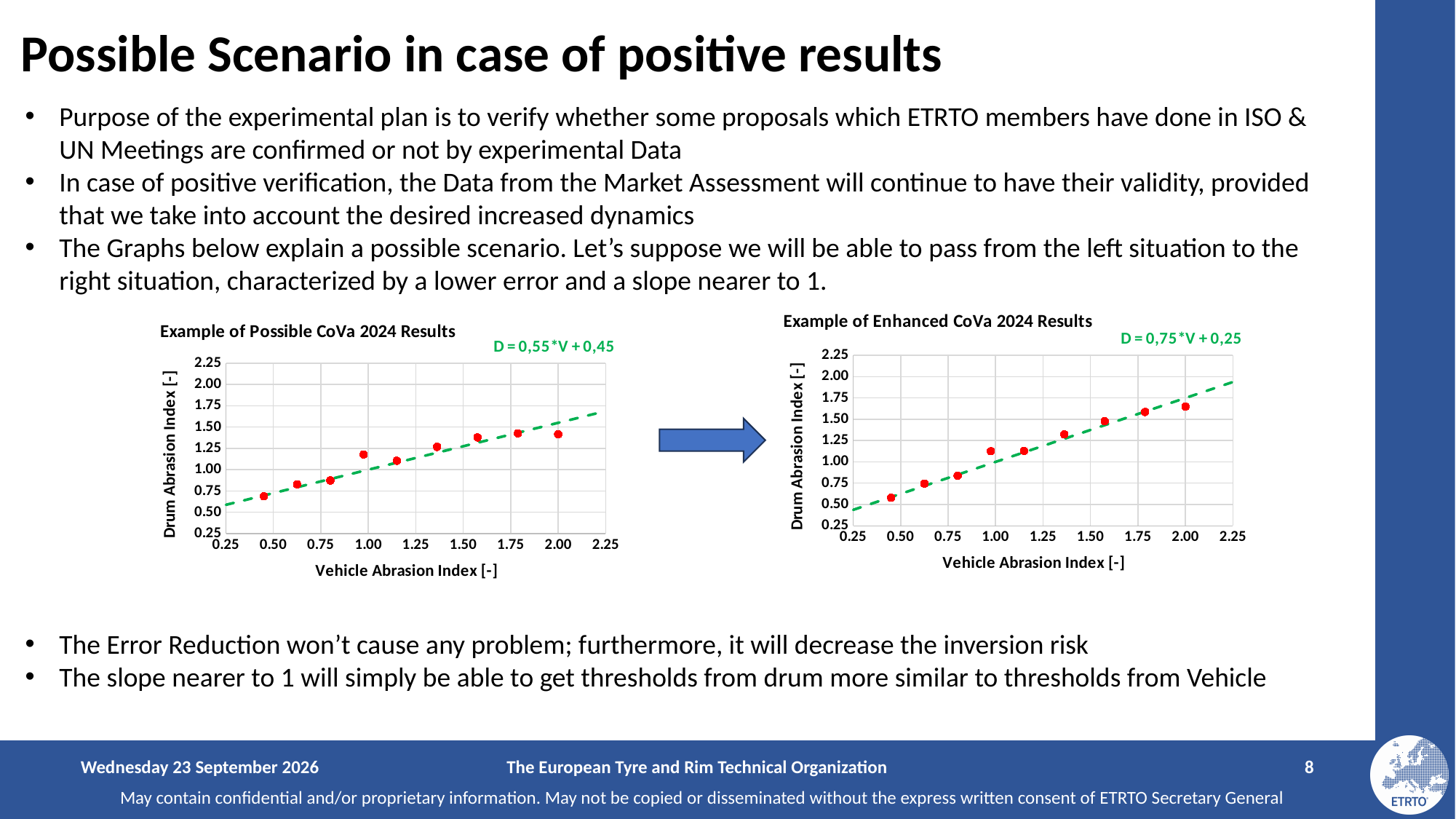
In the chart 'Example of Possible CoVa 2024 Results', is the Drum Abrasion Index of the point at Vehicle Abrasion Index 1.00 greater or less than 1.00? greater In the chart 'Example of Enhanced CoVa 2024 Results', is the Drum Abrasion Index of the point at Vehicle Abrasion Index 1.75 greater or less than 1.50? greater In the chart 'Example of Possible CoVa 2024 Results', is the Drum Abrasion Index of the point at Vehicle Abrasion Index 2.00 greater or less than 1.50? less What kind of chart is 'Example of Possible CoVa 2024 Results'? scatter chart What is the trend-line equation shown on the chart 'Example of Enhanced CoVa 2024 Results'? D = 0,75*V + 0,25 How many data points are plotted in the chart 'Example of Possible CoVa 2024 Results'? 9 What is the trend-line equation shown on the chart 'Example of Possible CoVa 2024 Results'? D = 0,55*V + 0,45 In the chart 'Example of Enhanced CoVa 2024 Results', do the plotted values rise or fall along the x axis? rise How many data points are plotted in the chart 'Example of Enhanced CoVa 2024 Results'? 9 In the chart 'Example of Possible CoVa 2024 Results', do the Drum Abrasion Index values rise or fall as the Vehicle Abrasion Index increases? rise